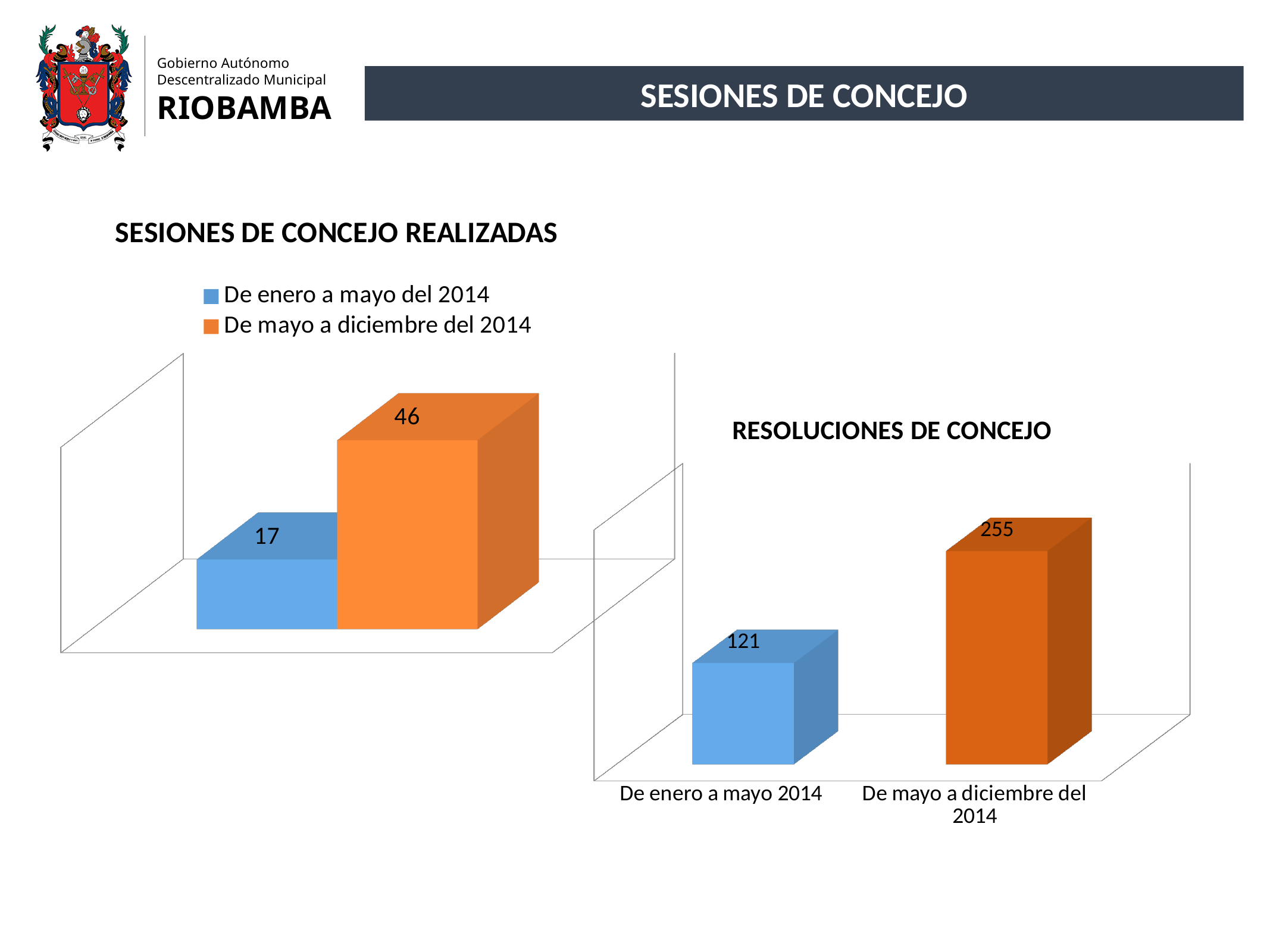
In the 'RESOLUCIONES DE CONCEJO' chart, what is the difference between the value for 'De mayo a diciembre del 2014' and 'De enero a mayo 2014'? 134 In the 'RESOLUCIONES DE CONCEJO' chart, which is larger: the value for 'De enero a mayo 2014' or 'De mayo a diciembre del 2014'? De mayo a diciembre del 2014 How many entries does the legend of the 'SESIONES DE CONCEJO REALIZADAS' chart list? 2 In the 'SESIONES DE CONCEJO REALIZADAS' chart, what is the value for 'De mayo a diciembre del 2014'? 46 In the 'SESIONES DE CONCEJO REALIZADAS' chart, which period has the highest value? De mayo a diciembre del 2014 How many bars are shown in the 'RESOLUCIONES DE CONCEJO' chart? 2 In the 'SESIONES DE CONCEJO REALIZADAS' chart, what is the difference between the two periods' values? 29 In the 'SESIONES DE CONCEJO REALIZADAS' chart, what is the value for 'De enero a mayo del 2014'? 17 In the 'RESOLUCIONES DE CONCEJO' chart, what is the value for 'De mayo a diciembre del 2014'? 255 In the 'RESOLUCIONES DE CONCEJO' chart, which period has the lowest value? De enero a mayo 2014 In the 'RESOLUCIONES DE CONCEJO' chart, what is the value for 'De enero a mayo 2014'? 121 What type of chart is the 'SESIONES DE CONCEJO REALIZADAS' chart? Bar chart